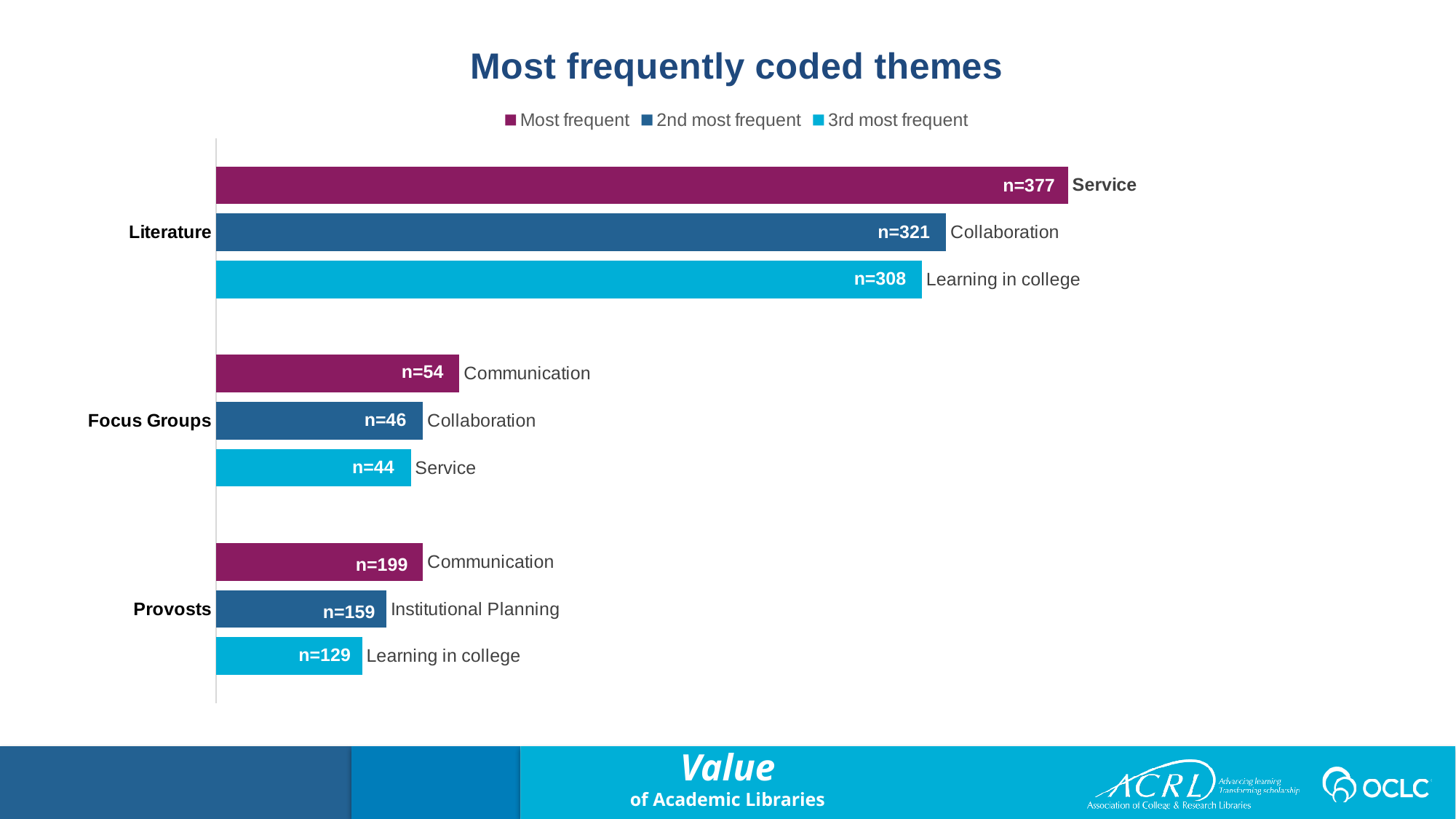
What is the value of the most frequent theme for Literature? n=377 What is the difference between the most frequent and 3rd most frequent values for Provosts? 70 How many series does the legend list? 3 What is the difference between the most frequent and 2nd most frequent values for Literature? 56 Which theme is the 3rd most frequent for Literature? Learning in college Which is larger: the 2nd most frequent value for Provosts or the most frequent value for Focus Groups? 2nd most frequent value for Provosts Which group has the highest value for its most frequent theme? Literature What is the value of the 2nd most frequent theme for Focus Groups? n=46 What kind of chart is shown on the slide? Bar chart What is the value of the 3rd most frequent theme for Provosts? n=129 Which group has the lowest value for its 3rd most frequent theme? Focus Groups Which theme is the most frequent for Provosts? Communication